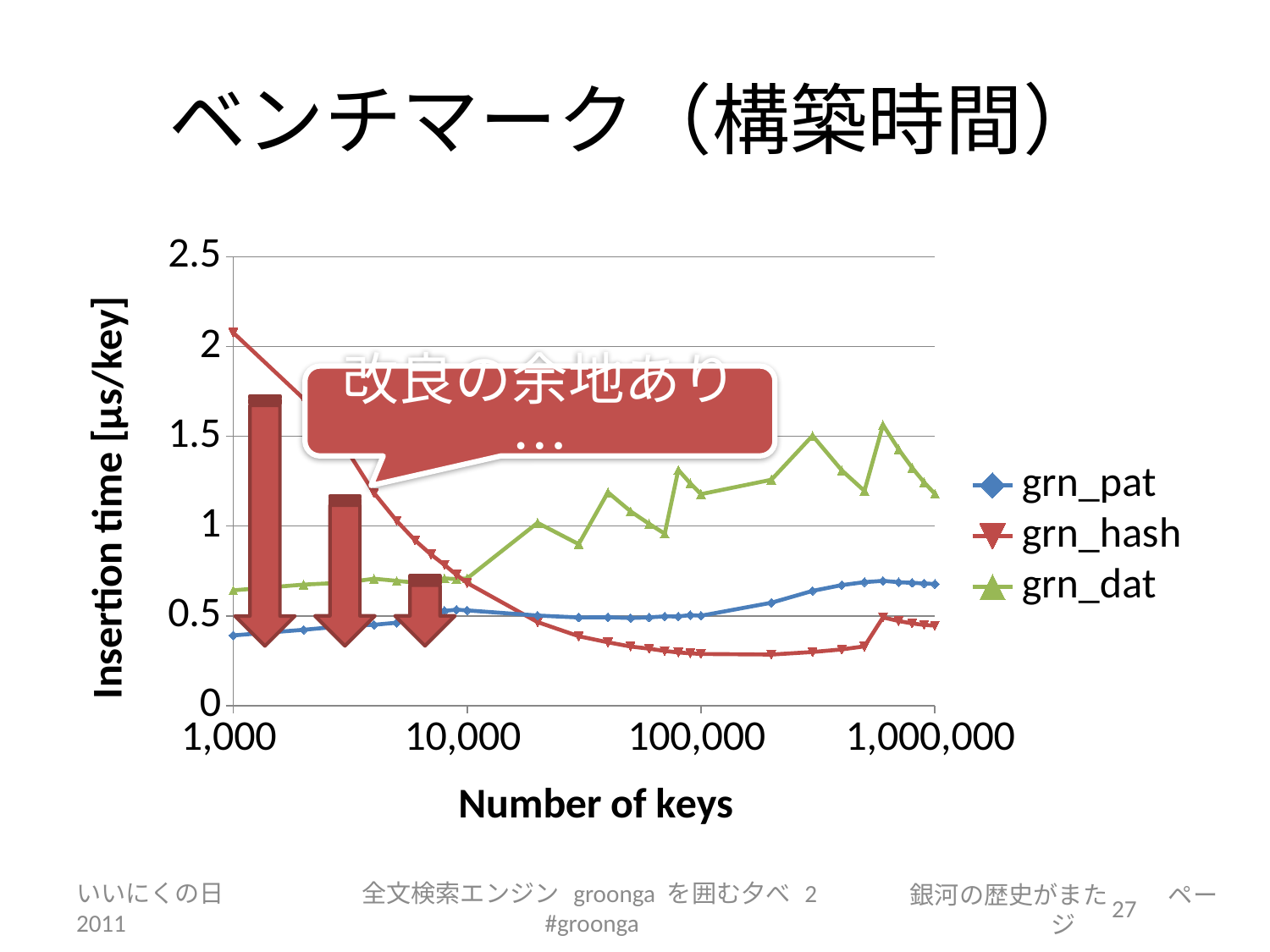
Does the grn_hash insertion time rise or fall as the number of keys increases from 1,000 to 100,000? fall How many series does the legend list? 3 At 1,000,000 keys, which series has the larger insertion time, grn_dat or grn_hash? grn_dat What are the series names listed in the legend? grn_pat, grn_hash, grn_dat Is the value for grn_hash at 100,000 keys greater or less than 0.5? less Is the value for grn_dat at 1,000,000 keys greater or less than 1.5? less What kind of chart is shown on the slide? line chart Which series has the highest insertion time at 1,000,000 keys? grn_dat At 1,000 keys, which series has the larger insertion time, grn_hash or grn_pat? grn_hash What is the label of the vertical axis? Insertion time [μs/key] Is the value for grn_hash at 1,000 keys greater or less than 1.5? greater